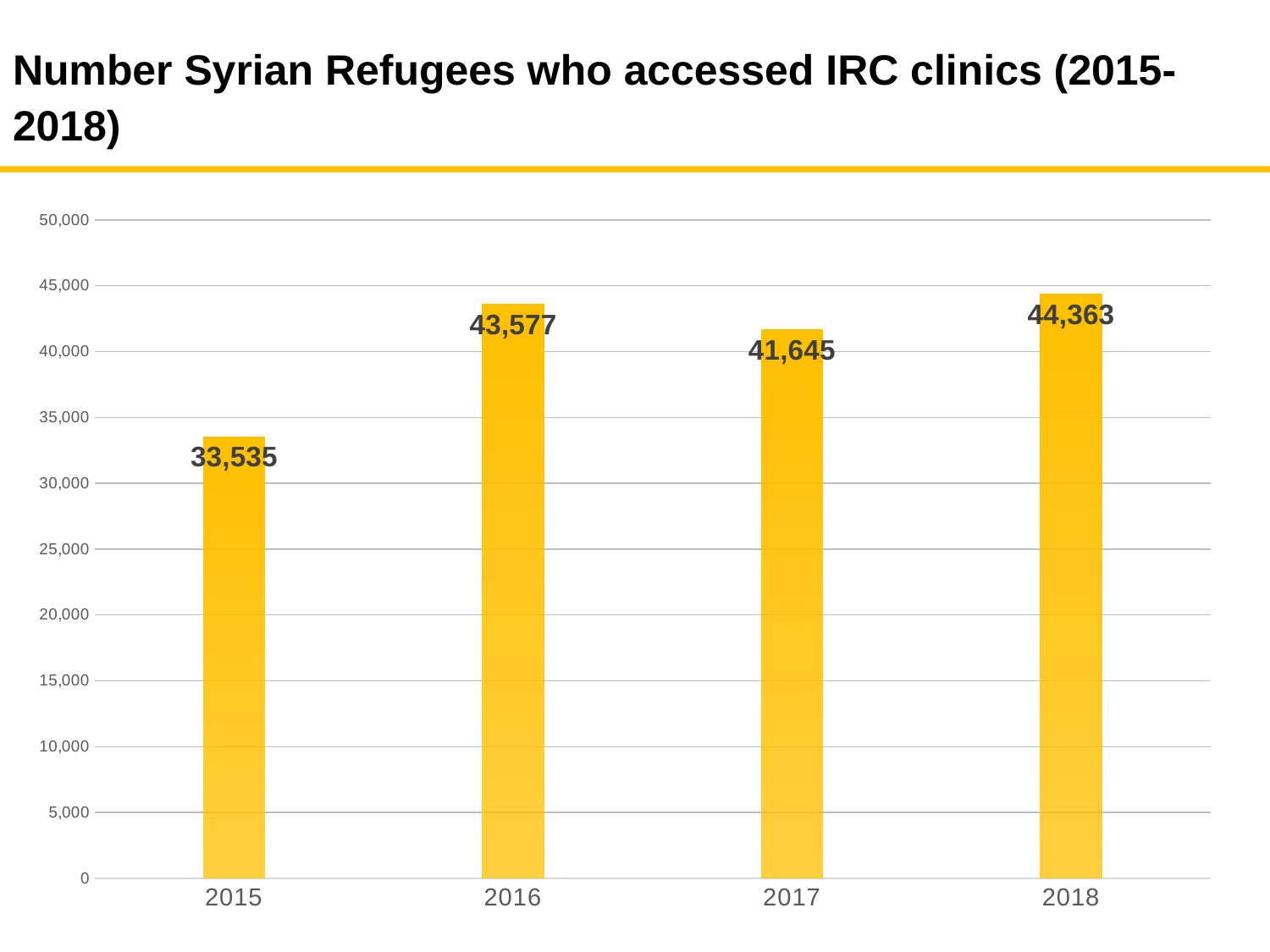
What is the value shown for 2018? 44,363 How many years are shown on the x axis of the chart? 4 Which year has a larger value, 2016 or 2017? 2016 Is the value for 2015 greater or less than 35,000? less What kind of chart is shown on the slide? bar chart Which year has the lowest number of Syrian refugees who accessed IRC clinics? 2015 What is the number of Syrian refugees who accessed IRC clinics in 2017? 41,645 What is the title of the chart on the slide? Number Syrian Refugees who accessed IRC clinics (2015-2018) What is the difference between the values for 2016 and 2015? 10,042 Which year has the highest number of Syrian refugees who accessed IRC clinics? 2018 What is the difference between the values for 2018 and 2017? 2,718 What is the number of Syrian refugees who accessed IRC clinics in 2015? 33,535